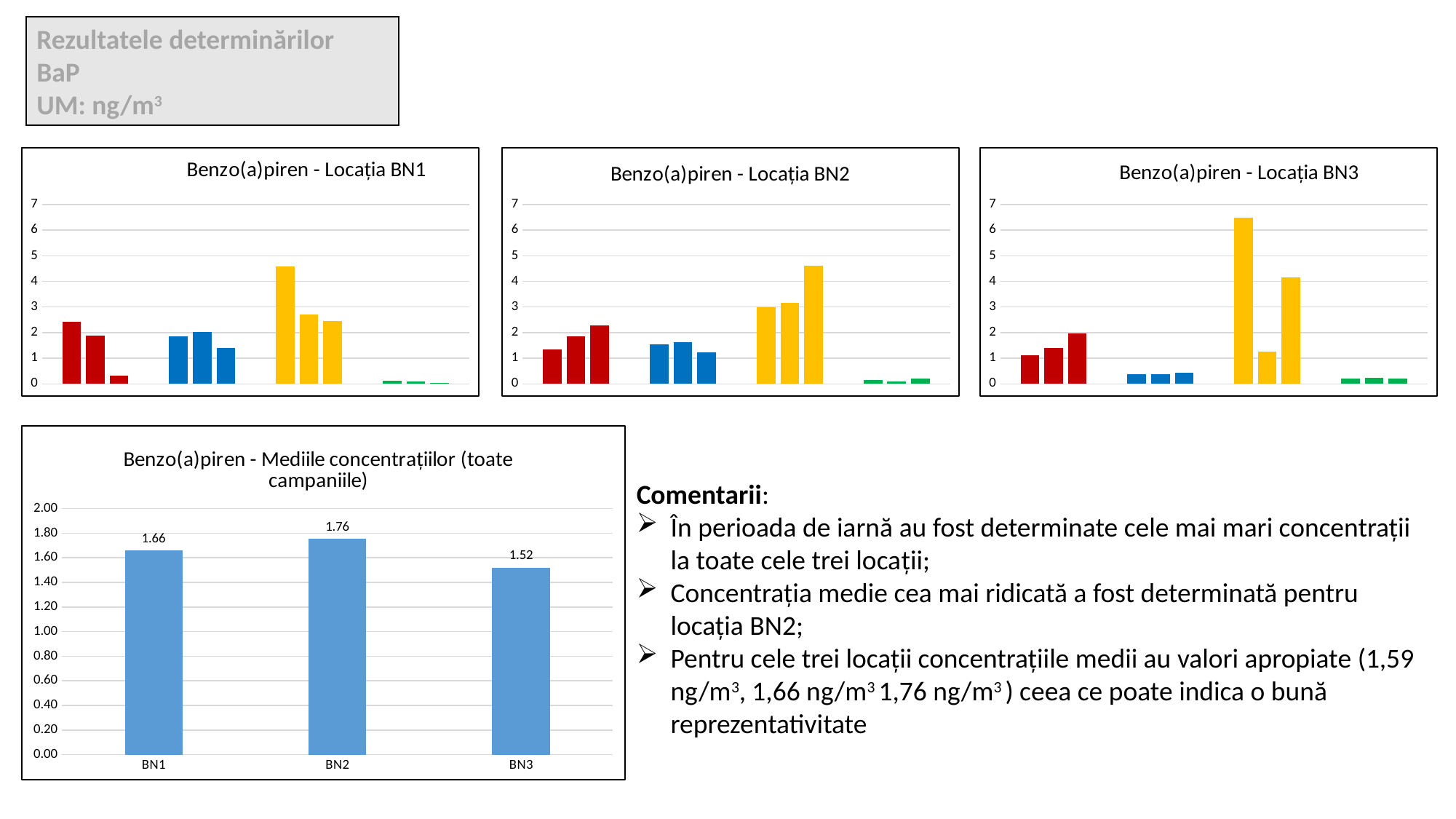
In the chart titled 'Benzo(a)piren - Mediile concentrațiilor (toate campaniile)', what is the value for BN1? 1.66 How many categories are shown in the chart titled 'Benzo(a)piren - Mediile concentrațiilor (toate campaniile)'? 3 In the chart titled 'Benzo(a)piren - Locația BN3', is the tallest bar greater or less than 6? greater In the chart titled 'Benzo(a)piren - Mediile concentrațiilor (toate campaniile)', which location has the highest value? BN2 In the chart titled 'Benzo(a)piren - Mediile concentrațiilor (toate campaniile)', which location has the lowest value? BN3 In the chart titled 'Benzo(a)piren - Locația BN1', is the tallest bar greater or less than 5? less In the chart titled 'Benzo(a)piren - Mediile concentrațiilor (toate campaniile)', what is the value for BN2? 1.76 What kind of chart is the one titled 'Benzo(a)piren - Locația BN1'? bar chart In the chart titled 'Benzo(a)piren - Mediile concentrațiilor (toate campaniile)', what is the value for BN3? 1.52 In the chart titled 'Benzo(a)piren - Mediile concentrațiilor (toate campaniile)', which is larger, the value for BN1 or the value for BN3? BN1 How many bars are plotted in the chart titled 'Benzo(a)piren - Locația BN2'? 12 In the chart titled 'Benzo(a)piren - Mediile concentrațiilor (toate campaniile)', what is the difference between the values for BN2 and BN3? 0.24